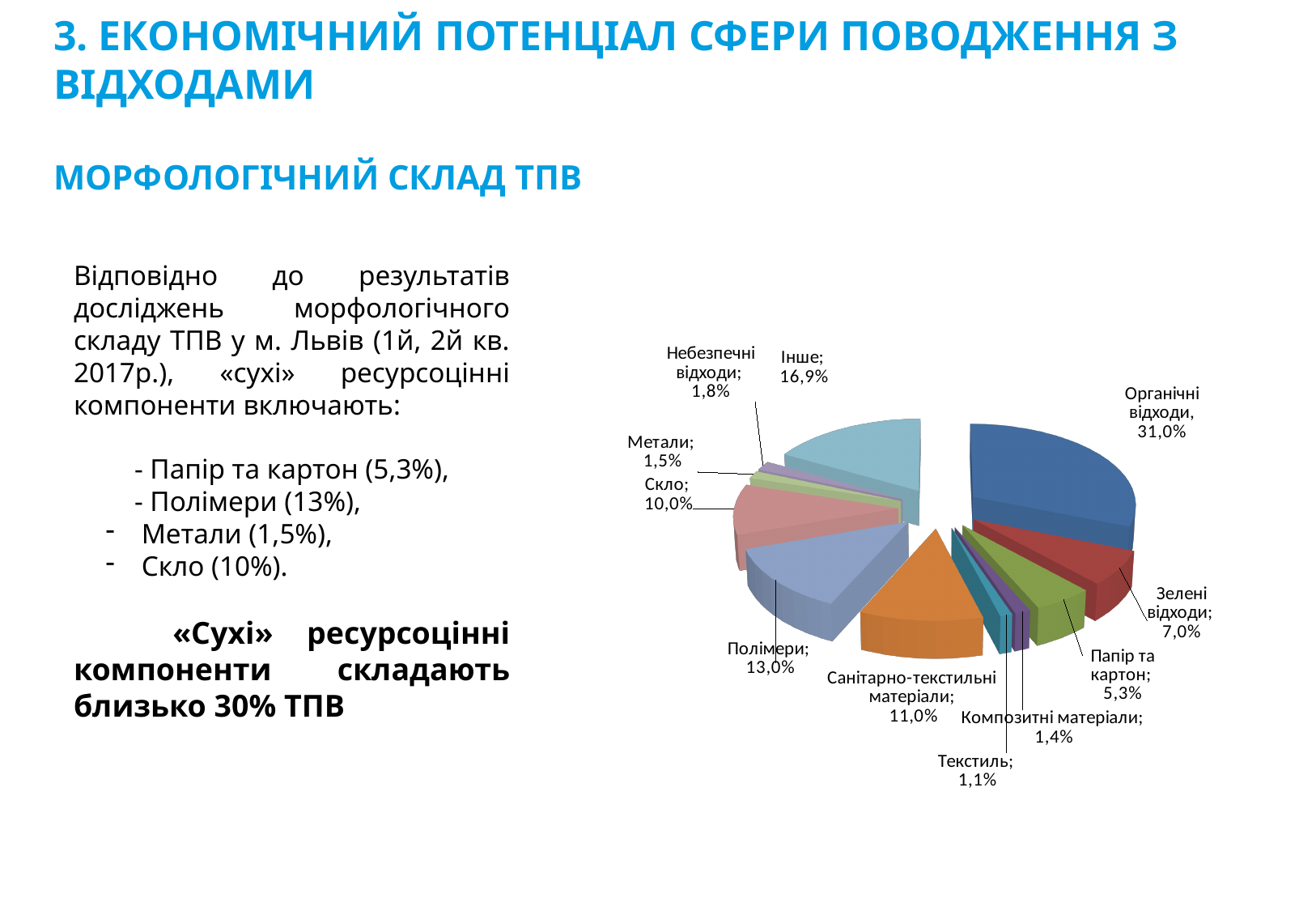
What is the value shown for Композитні матеріали? 1,4% What kind of chart is shown on the slide? Pie chart Which is larger, the share for Зелені відходи or the share for Папір та картон? Зелені відходи What is the value shown for Полімери? 13,0% What is the combined share of Метали and Небезпечні відходи? 3,3% Which category has the smallest slice of the pie? Текстиль What is the value for Санітарно-текстильні матеріали? 11,0% What share of the pie does Органічні відходи represent? 31,0% What percentage is labelled for Скло? 10,0% What is the difference between the shares of Органічні відходи and Інше? 14,1% How many categories (slices) does the pie chart show? 11 Which category has the largest slice of the pie? Органічні відходи